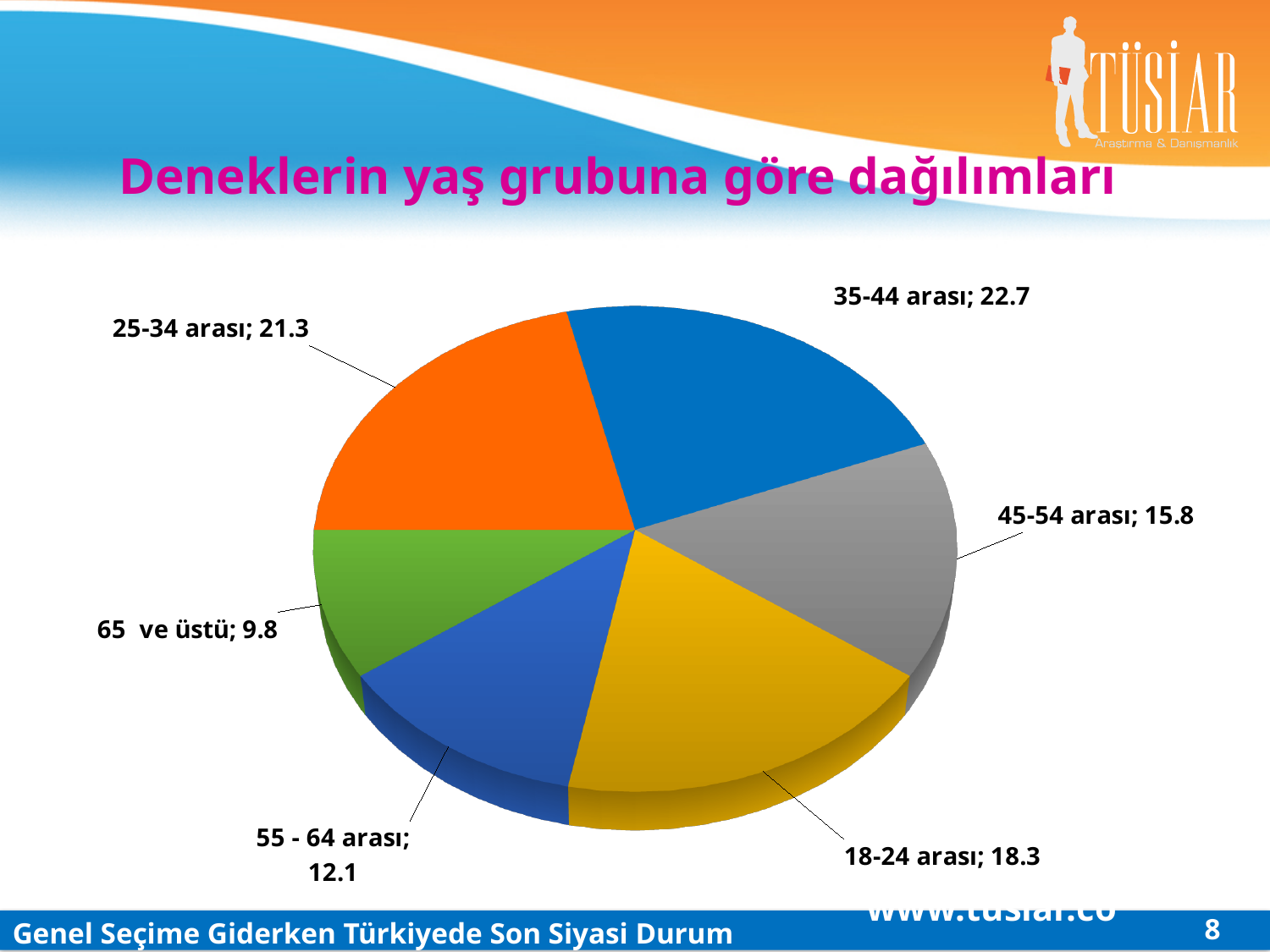
What is the value for the 55 - 64 arası age group? 12.1 How many age groups are shown in the pie chart? 6 What kind of chart is shown on the slide? Pie chart What is the value for the 18-24 arası age group? 18.3 What is the title of the chart on the slide? Deneklerin yaş grubuna göre dağılımları Which age group has the smallest share of the pie? 65 ve üstü What is the difference between the values for 35-44 arası and 25-34 arası? 1.4 Which age group has the largest share of the pie? 35-44 arası What is the value for the 65 ve üstü age group? 9.8 What is the difference between the values for 18-24 arası and 45-54 arası? 2.5 What is the value for the 35-44 arası age group? 22.7 Which is larger, the value for 45-54 arası or the value for 55 - 64 arası? 45-54 arası